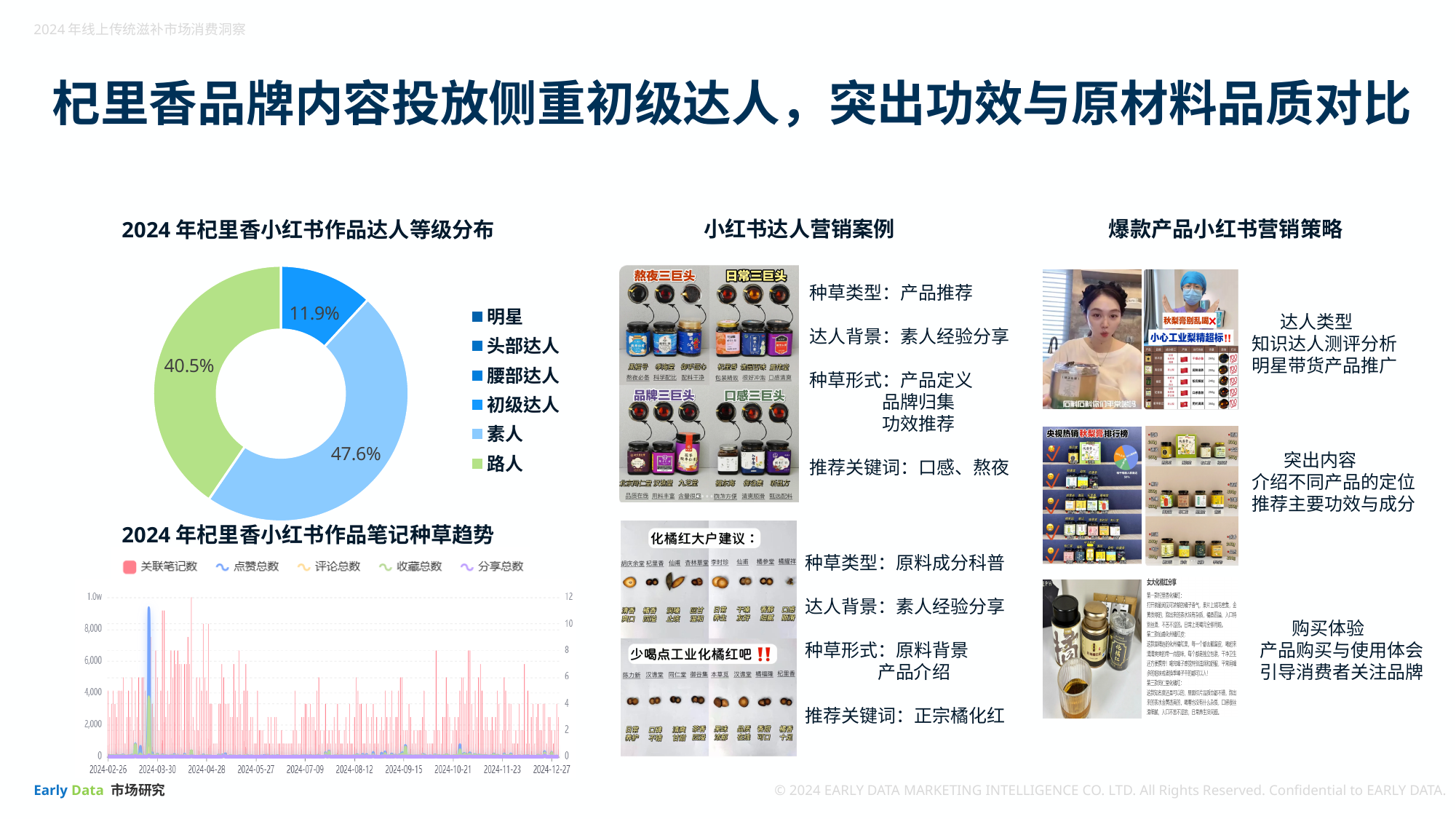
How many series does the legend of the chart '2024 年杞里香小红书作品笔记种草趋势' list? 5 In the donut chart '2024 年杞里香小红书作品达人等级分布', what is the difference between the shares for 素人 and 路人? 7.1% What kind of chart is '2024 年杞里香小红书作品笔记种草趋势'? Bar chart In the chart '2024 年杞里香小红书作品笔记种草趋势', what is the last date label on the x axis? 2024-12-27 In the donut chart '2024 年杞里香小红书作品达人等级分布', what share is shown for 素人? 47.6% In the donut chart '2024 年杞里香小红书作品达人等级分布', which is larger, the share for 路人 or for 初级达人? 路人 In the donut chart '2024 年杞里香小红书作品达人等级分布', which category has the largest share? 素人 In the donut chart '2024 年杞里香小红书作品达人等级分布', what share is shown for 路人? 40.5% In the chart '2024 年杞里香小红书作品笔记种草趋势', what is the first date label on the x axis? 2024-02-26 In the donut chart '2024 年杞里香小红书作品达人等级分布', what share is shown for 初级达人? 11.9% What kind of chart is '2024 年杞里香小红书作品达人等级分布'? Donut (pie) chart How many categories does the legend of the donut chart '2024 年杞里香小红书作品达人等级分布' list? 6